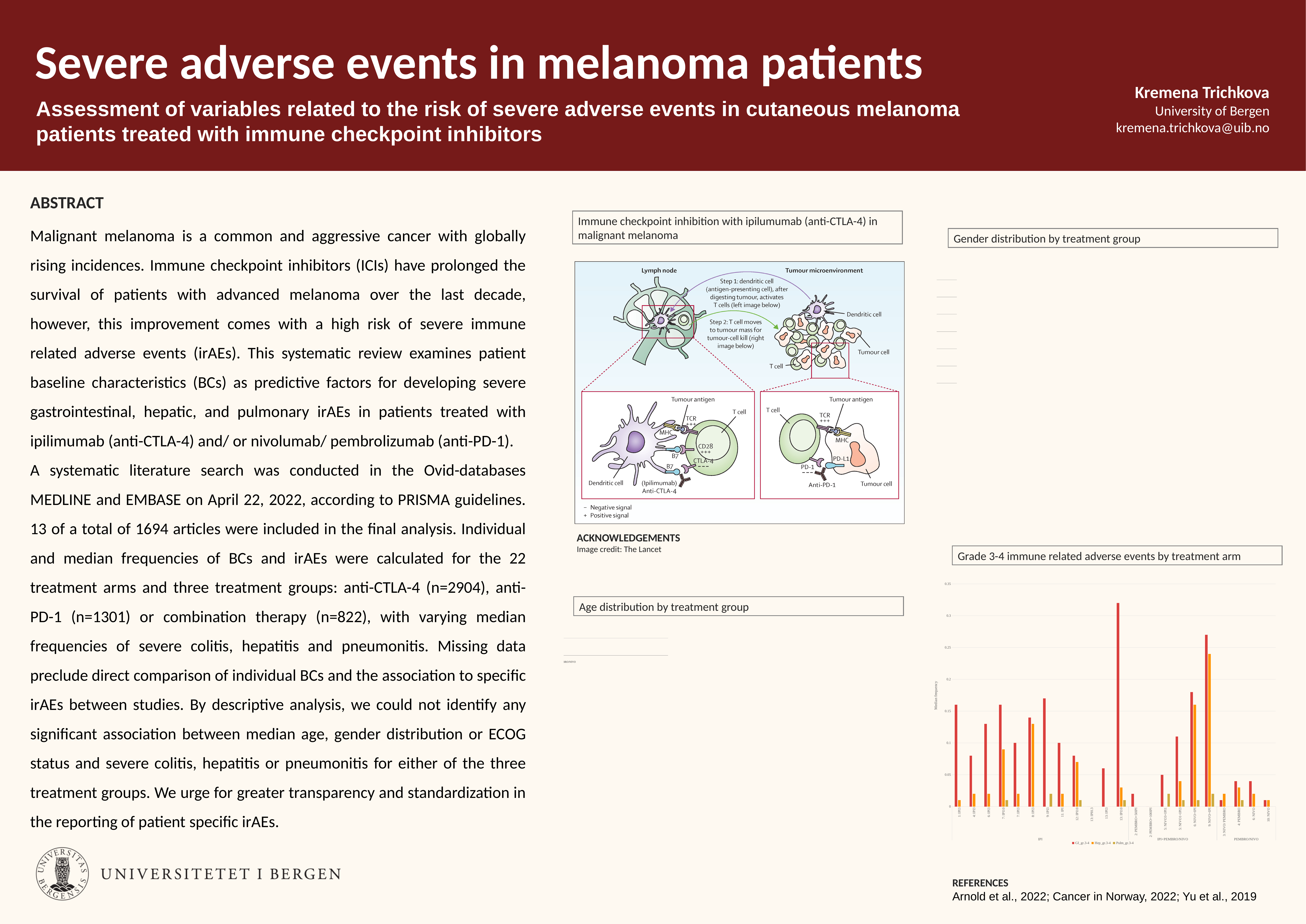
In the 'Grade 3-4 immune related adverse events by treatment arm' chart, is the highest plotted value greater or less than 0.3? greater What kind of chart is 'Grade 3-4 immune related adverse events by treatment arm'? bar chart What are the three legend entries in the 'Grade 3-4 immune related adverse events by treatment arm' chart? GI_gr.3-4, Hep_gr.3-4, Pulm_gr.3-4 How many treatment groups are labelled along the x axis of the 'Grade 3-4 immune related adverse events by treatment arm' chart? 3 How many series does the legend of the 'Grade 3-4 immune related adverse events by treatment arm' chart list? 3 In the 'Grade 3-4 immune related adverse events by treatment arm' chart, which series does the tallest bar belong to? GI_gr.3-4 What is the y-axis label of the 'Grade 3-4 immune related adverse events by treatment arm' chart? Median frequency